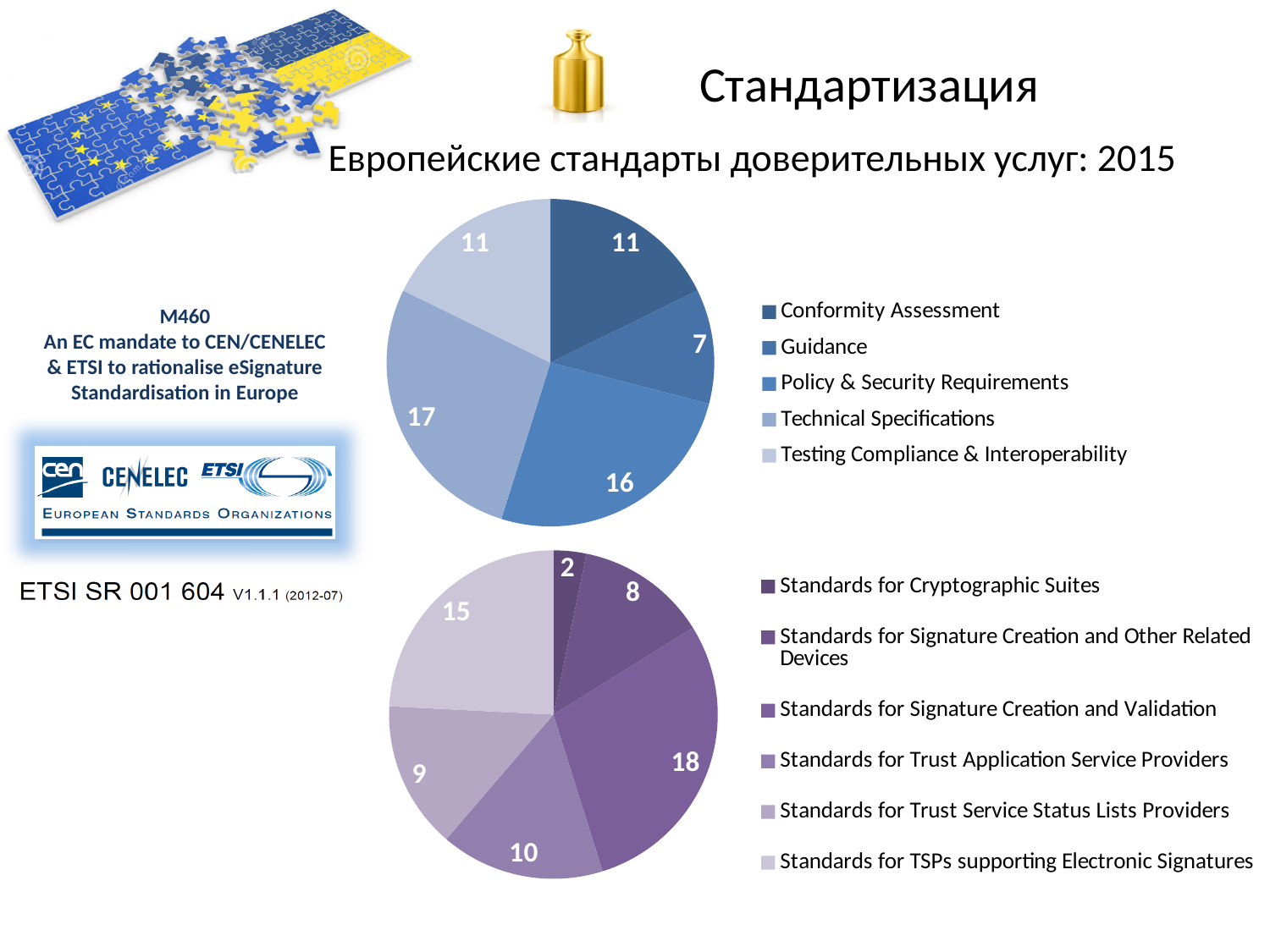
In the lower pie chart, which category has the largest value? Standards for Signature Creation and Validation How many categories does the legend of the lower pie chart list? 6 In the upper pie chart, what is the value for Technical Specifications? 17 In the lower pie chart, which category has the smallest value? Standards for Cryptographic Suites In the lower pie chart, which is larger: Standards for TSPs supporting Electronic Signatures or Standards for Trust Application Service Providers? Standards for TSPs supporting Electronic Signatures In the lower pie chart, what is the difference between Standards for Signature Creation and Validation and Standards for Signature Creation and Other Related Devices? 10 In the upper pie chart, what is the difference between Policy & Security Requirements and Guidance? 9 What kind of chart is the upper chart on the slide? Pie chart In the upper pie chart, which category has the smallest value? Guidance In the lower pie chart, what is the value for Standards for Trust Service Status Lists Providers? 9 How many categories does the legend of the upper pie chart list? 5 In the upper pie chart, what is the value for Guidance? 7